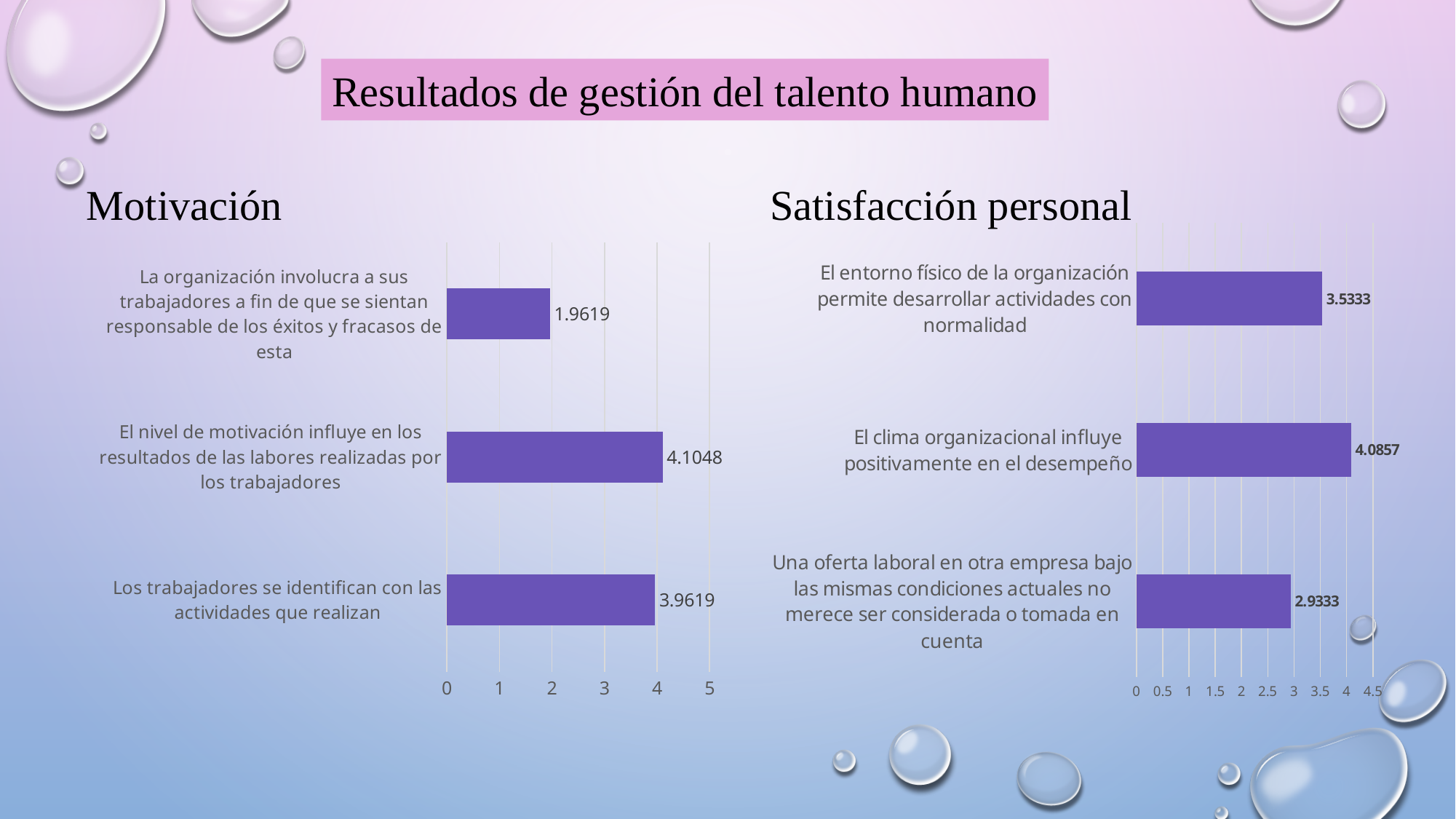
In the Satisfacción personal chart, what is the difference between the values for 'El entorno físico de la organización permite desarrollar actividades con normalidad' and 'Una oferta laboral en otra empresa bajo las mismas condiciones actuales no merece ser considerada o tomada en cuenta'? 0.6 In the Satisfacción personal chart, what is the value for 'El clima organizacional influye positivamente en el desempeño'? 4.0857 In the Motivación chart, what is the value for 'La organización involucra a sus trabajadores a fin de que se sientan responsable de los éxitos y fracasos de esta'? 1.9619 In the Satisfacción personal chart, which is larger: the value for 'El entorno físico de la organización permite desarrollar actividades con normalidad' or for 'Una oferta laboral en otra empresa bajo las mismas condiciones actuales no merece ser considerada o tomada en cuenta'? El entorno físico de la organización permite desarrollar actividades con normalidad In the Satisfacción personal chart, what is the value for 'Una oferta laboral en otra empresa bajo las mismas condiciones actuales no merece ser considerada o tomada en cuenta'? 2.9333 In the Motivación chart, which category has the lowest value? La organización involucra a sus trabajadores a fin de que se sientan responsable de los éxitos y fracasos de esta In the Satisfacción personal chart, which category has the highest value? El clima organizacional influye positivamente en el desempeño What kind of chart is the Satisfacción personal chart? Bar chart What is the title shown at the top of the slide? Resultados de gestión del talento humano In the Motivación chart, what is the value for 'El nivel de motivación influye en los resultados de las labores realizadas por los trabajadores'? 4.1048 How many categories does the Motivación chart show? 3 In the Motivación chart, what is the difference between the values for 'El nivel de motivación influye en los resultados de las labores realizadas por los trabajadores' and 'Los trabajadores se identifican con las actividades que realizan'? 0.1429